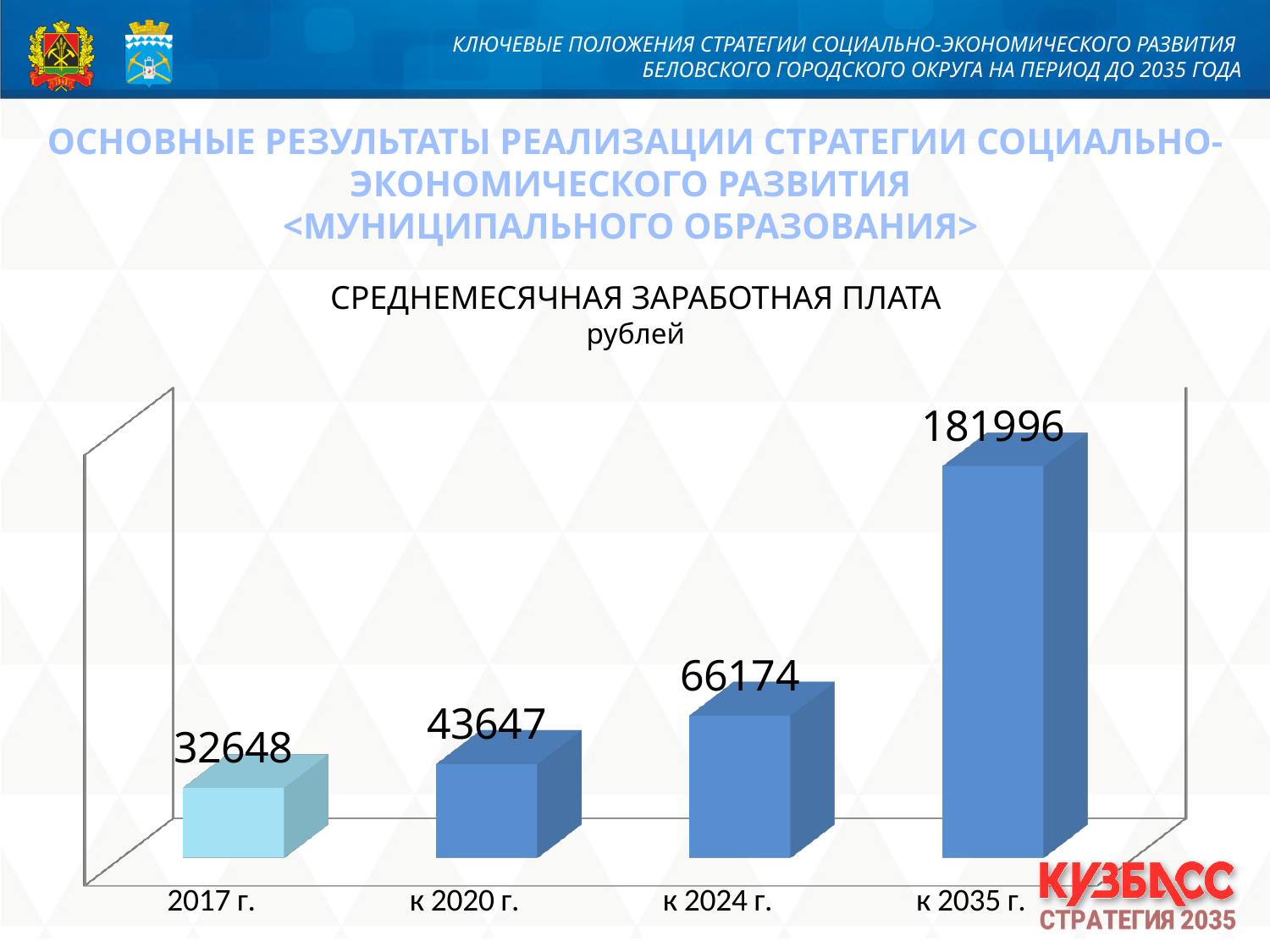
What is the difference between the values for к 2020 г. and 2017 г.? 10999 What value is shown for к 2035 г.? 181996 Which category has the lowest value? 2017 г. What value is shown for к 2020 г.? 43647 What value is shown for к 2024 г.? 66174 Which category has the highest value? к 2035 г. What is the difference between the values for к 2035 г. and к 2024 г.? 115822 What is the average monthly salary value shown for 2017 г.? 32648 Do the values rise or fall from 2017 г. to к 2035 г.? rise What kind of chart is shown on the slide? bar chart Which is larger, the value for к 2024 г. or the value for к 2020 г.? к 2024 г. How many categories are shown on the x axis? 4